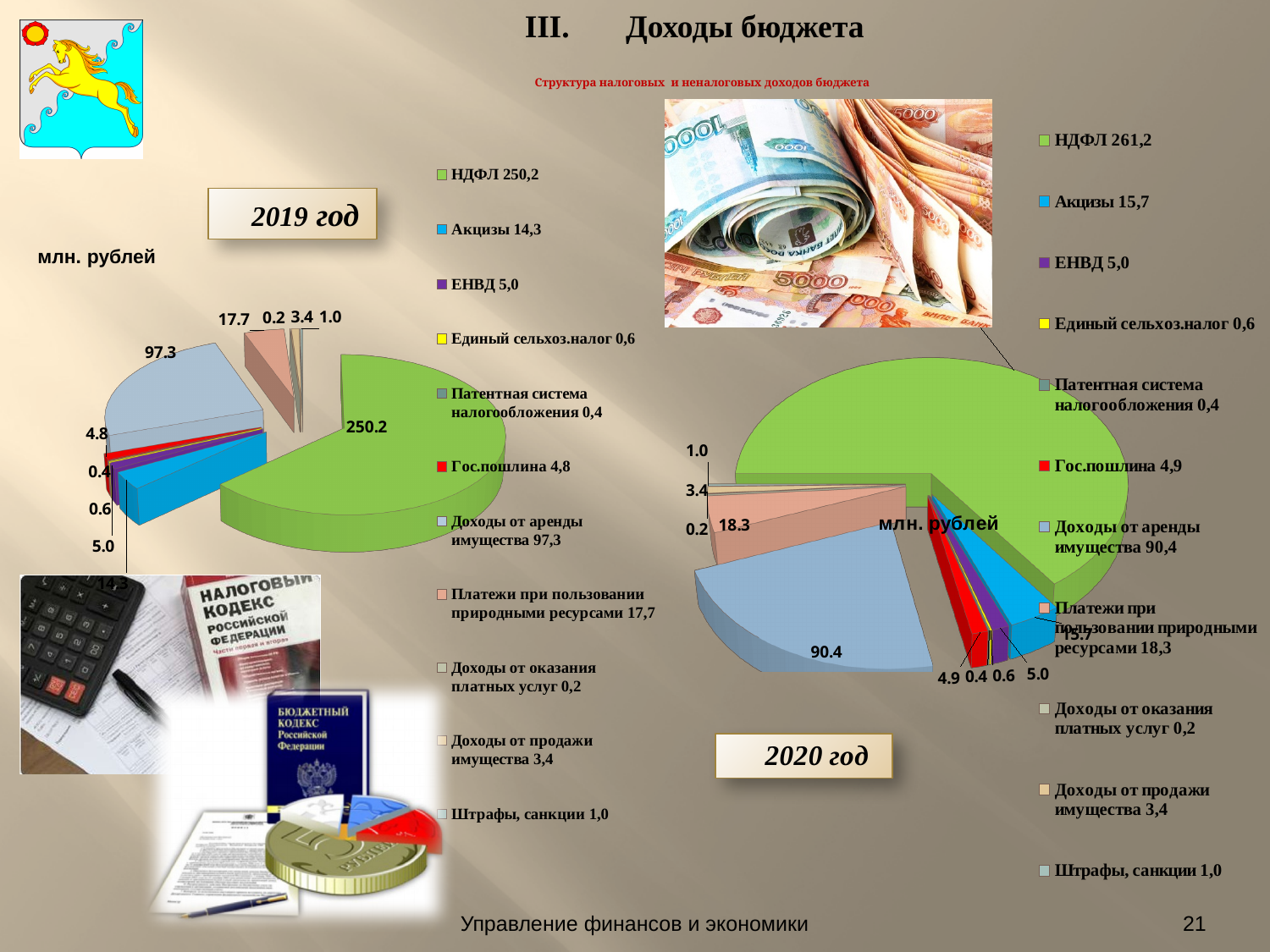
What type of chart is used for the 2019 год data? Pie chart In the 2019 год chart, what is the difference between НДФЛ and Доходы от аренды имущества? 152.9 What is the difference between the НДФЛ value in the 2020 год chart and the НДФЛ value in the 2019 год chart? 11.0 In the 2019 год chart, what is the value for НДФЛ? 250.2 In the 2020 год chart, which is larger: Акцизы or ЕНВД? Акцизы How many categories does the 2020 год chart's legend list? 11 In the 2019 год chart, which category has the smallest value? Доходы от оказания платных услуг In the 2020 год chart, which category has the largest value? НДФЛ In the 2020 год chart, what is the value for Доходы от аренды имущества? 90.4 What unit is stated for the values in the 2019 год chart? млн. рублей In the 2019 год chart, what is the value for Акцизы? 14.3 In the 2020 год chart, what is the value for Платежи при пользовании природными ресурсами? 18.3